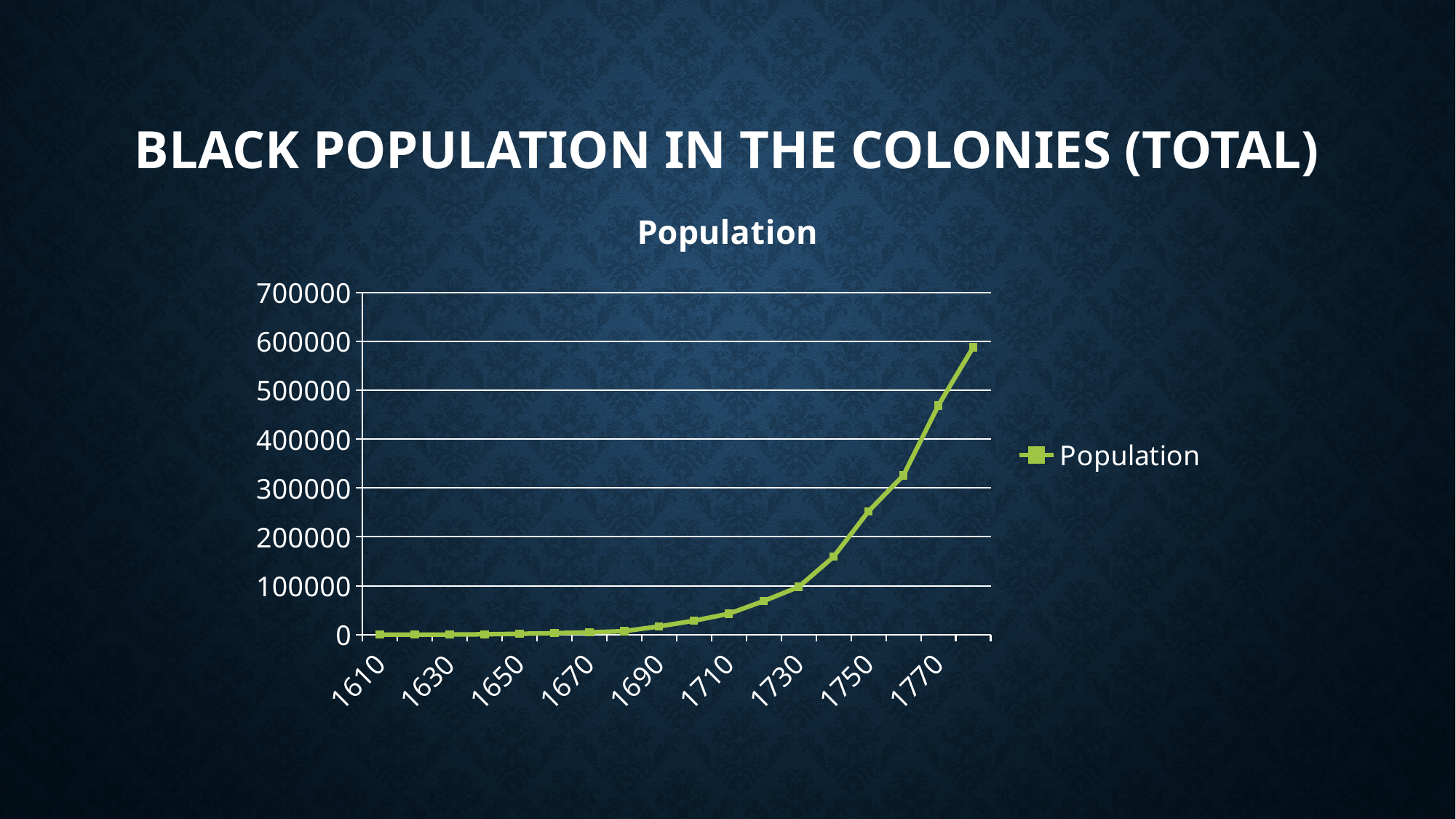
Which has the larger value, 1750 or 1770? 1770 How many series does the legend list? 1 Is the value for 1770 greater or less than 500000? less Of the years labeled on the x axis, which has the highest value? 1770 Is the value for 1750 greater or less than 200000? greater Is the value for 1770 greater or less than 400000? greater What is the name of the series shown in the legend? Population What kind of chart is shown on the slide? line chart Which has the larger value, 1690 or 1710? 1710 What is the title of the chart? Population Do the values rise or fall as the years increase along the x axis? rise